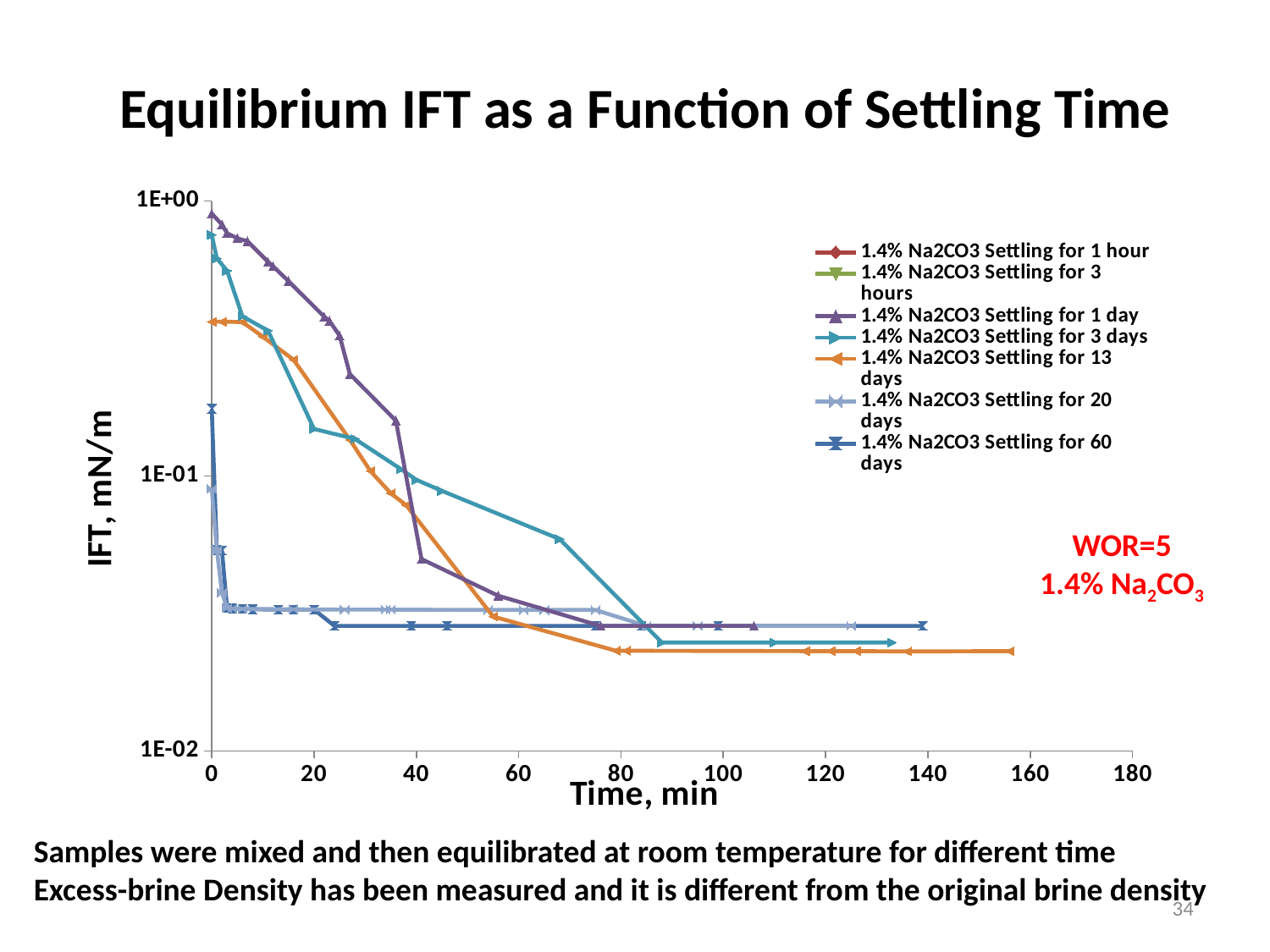
Do the IFT values for the '1.4% Na2CO3 Settling for 13 days' series rise or fall as time increases? fall Which series has the highest IFT value at time 0? 1.4% Na2CO3 Settling for 1 day Is the value for the '1.4% Na2CO3 Settling for 3 days' series at 120 min greater or less than 1E-01? less Which series extends to the largest time value on the x axis? 1.4% Na2CO3 Settling for 13 days What is the label of the y axis? IFT, mN/m What is the title of the chart? Equilibrium IFT as a Function of Settling Time Is the value for the '1.4% Na2CO3 Settling for 1 day' series at time 0 greater or less than 1E-01? greater Is the value for the '1.4% Na2CO3 Settling for 60 days' series at 140 min greater or less than 1E-01? less How many series does the legend list? 7 At time 0, which series has the higher IFT: '1.4% Na2CO3 Settling for 1 day' or '1.4% Na2CO3 Settling for 60 days'? 1.4% Na2CO3 Settling for 1 day What kind of chart is shown on the slide? line chart